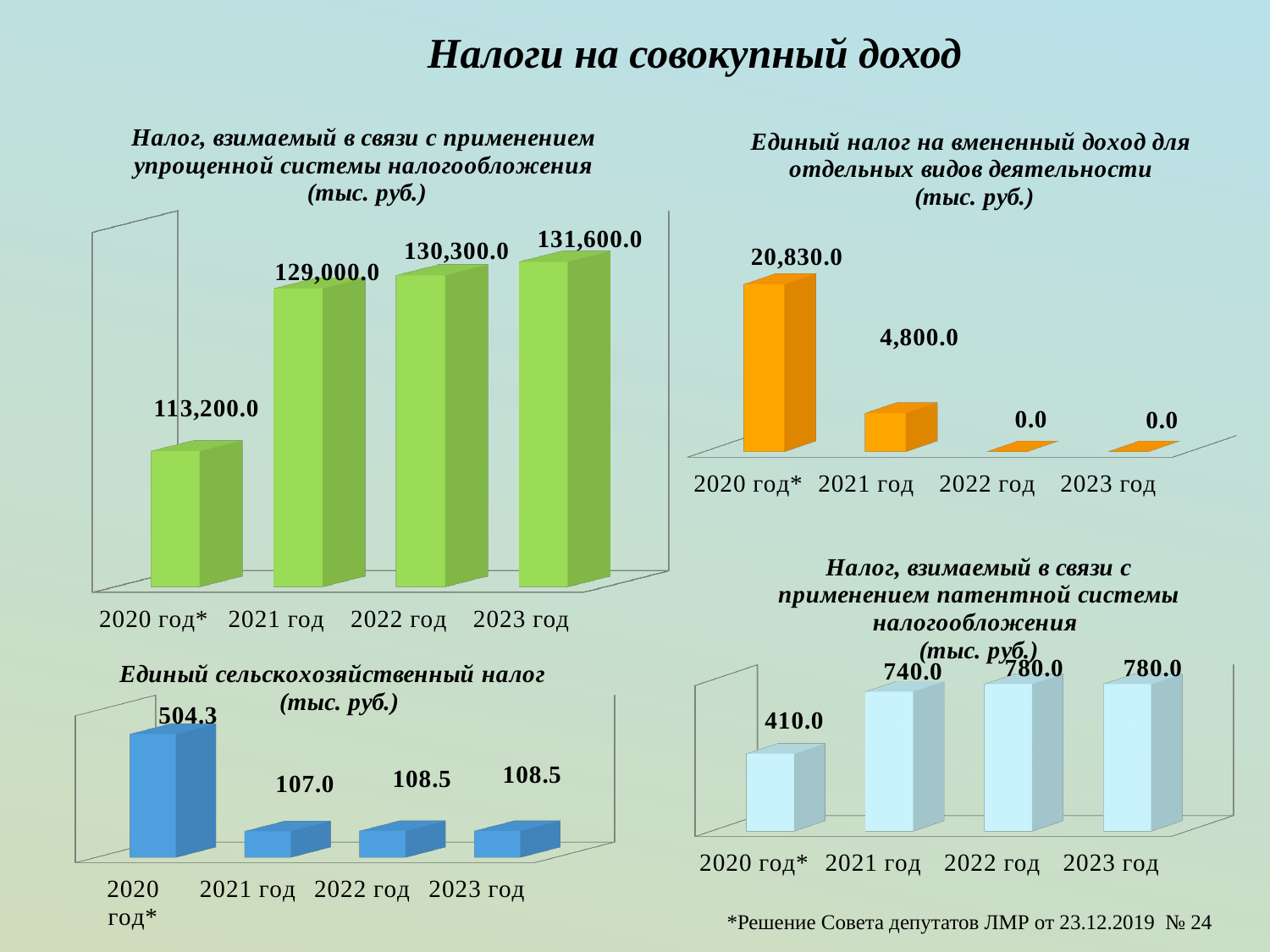
In the chart 'Налог, взимаемый в связи с применением патентной системы налогообложения', what is the value for 2020 год*? 410.0 In the chart 'Налог, взимаемый в связи с применением упрощенной системы налогообложения', what is the difference between the values for 2023 год and 2020 год*? 18,400.0 In the chart 'Налог, взимаемый в связи с применением упрощенной системы налогообложения', which year has the lowest value? 2020 год* In the chart 'Единый налог на вмененный доход для отдельных видов деятельности', what is the value for 2020 год*? 20,830.0 In the chart 'Налог, взимаемый в связи с применением патентной системы налогообложения', which is larger, the value for 2021 год or the value for 2022 год? 2022 год In the chart 'Налог, взимаемый в связи с применением упрощенной системы налогообложения', what is the value for 2021 год? 129,000.0 In the chart 'Единый сельскохозяйственный налог', which year has the highest value? 2020 год* In the chart 'Единый налог на вмененный доход для отдельных видов деятельности', what is the value for 2022 год? 0.0 In the chart 'Налог, взимаемый в связи с применением упрощенной системы налогообложения', do the values rise or fall from 2020 год* to 2023 год? rise In the chart 'Единый сельскохозяйственный налог', what is the value for 2021 год? 107.0 How many charts are shown on the slide? 4 In the chart 'Единый налог на вмененный доход для отдельных видов деятельности', what is the difference between the values for 2020 год* and 2021 год? 16,030.0